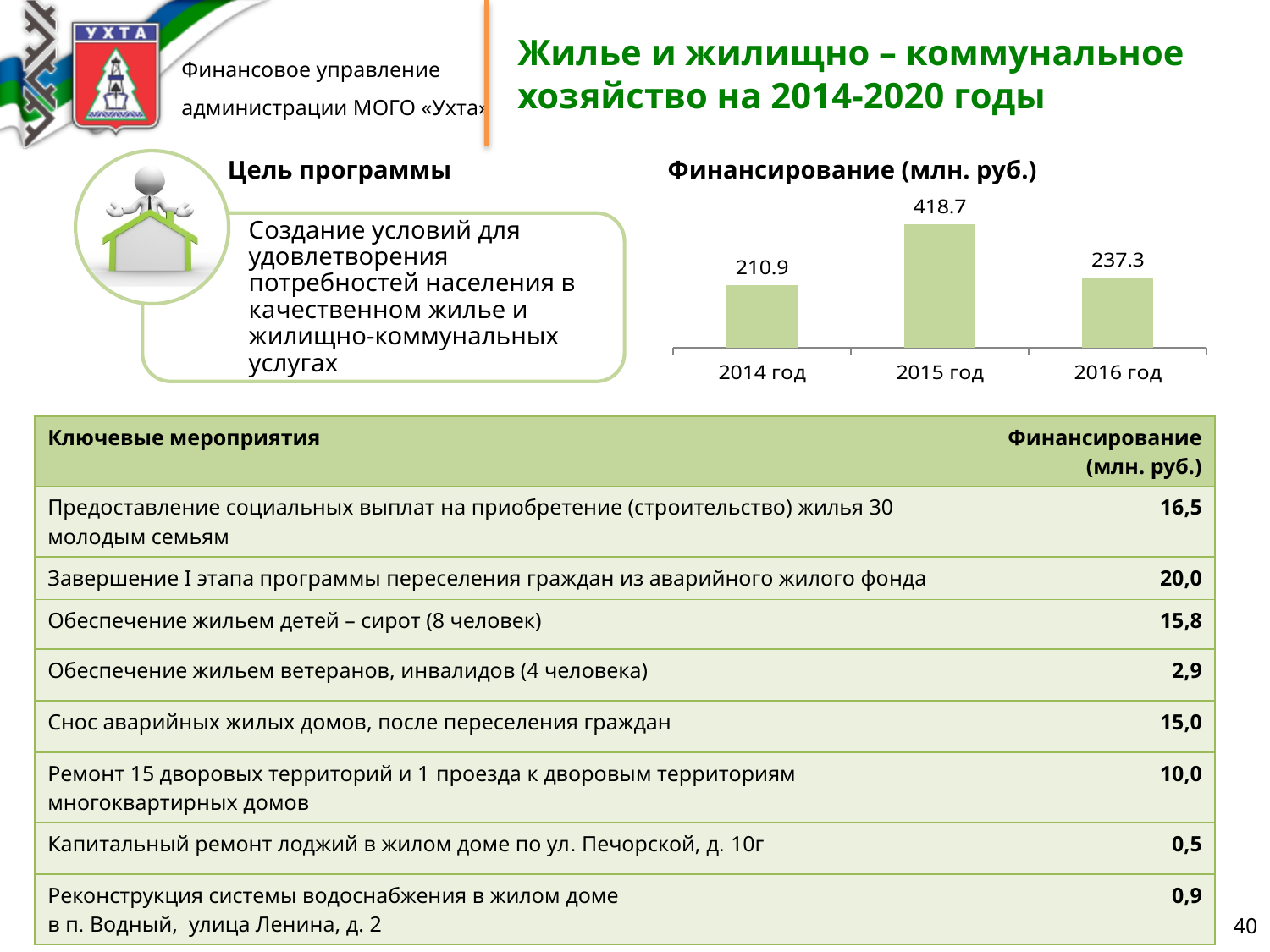
Which year has the highest value in the chart? 2015 год What kind of chart is shown on the slide? bar chart What is the value for 2016 год in the chart? 237.3 What is the difference between the values for 2015 год and 2014 год? 207.8 What is the value for 2014 год in the chart? 210.9 What is the title of the chart? Финансирование (млн. руб.) What is the difference between the values for 2016 год and 2014 год? 26.4 Which is larger, the value for 2016 год or the value for 2014 год? 2016 год Does the value rise or fall from 2015 год to 2016 год? fall Which year has the lowest value in the chart? 2014 год What is the value for 2015 год in the chart? 418.7 How many years are shown in the chart? 3